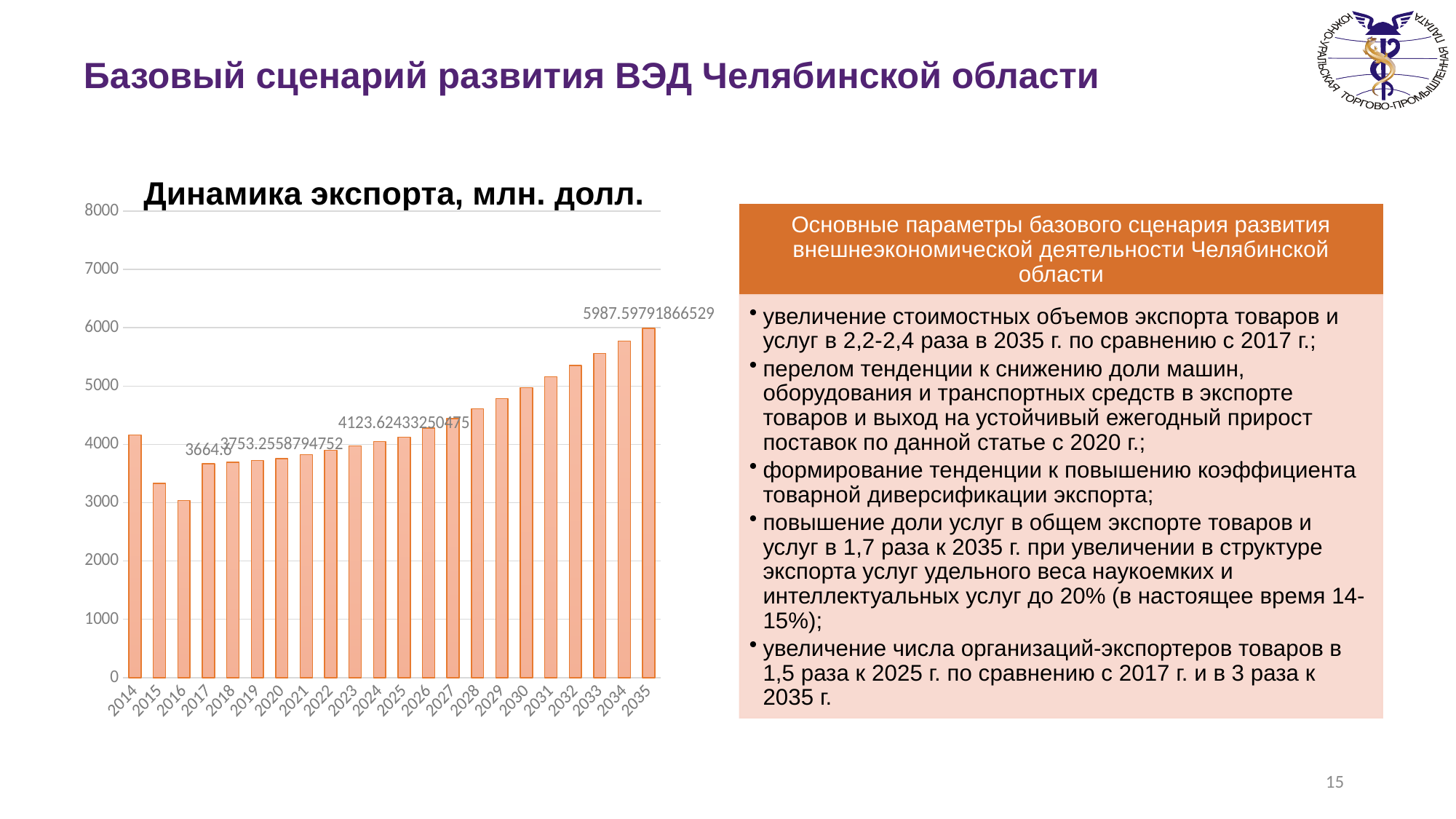
Which year has the lowest export value in the chart? 2016 What kind of chart is shown on the slide? bar chart Is the value for 2031 greater or less than 5000? greater How many years are shown on the x axis of the chart? 22 Which is larger, the value for 2014 or the value for 2015? 2014 Is the value for 2022 greater or less than 4000? less What is the export value labelled for 2017? 3664.6 What is the title of the chart? Динамика экспорта, млн. долл. Do the export values rise or fall from 2016 to 2035? rise Which year has the highest export value in the chart? 2035 What is the export value labelled for 2035? 5987.59791866529 Is the value for 2014 greater or less than 4000? greater